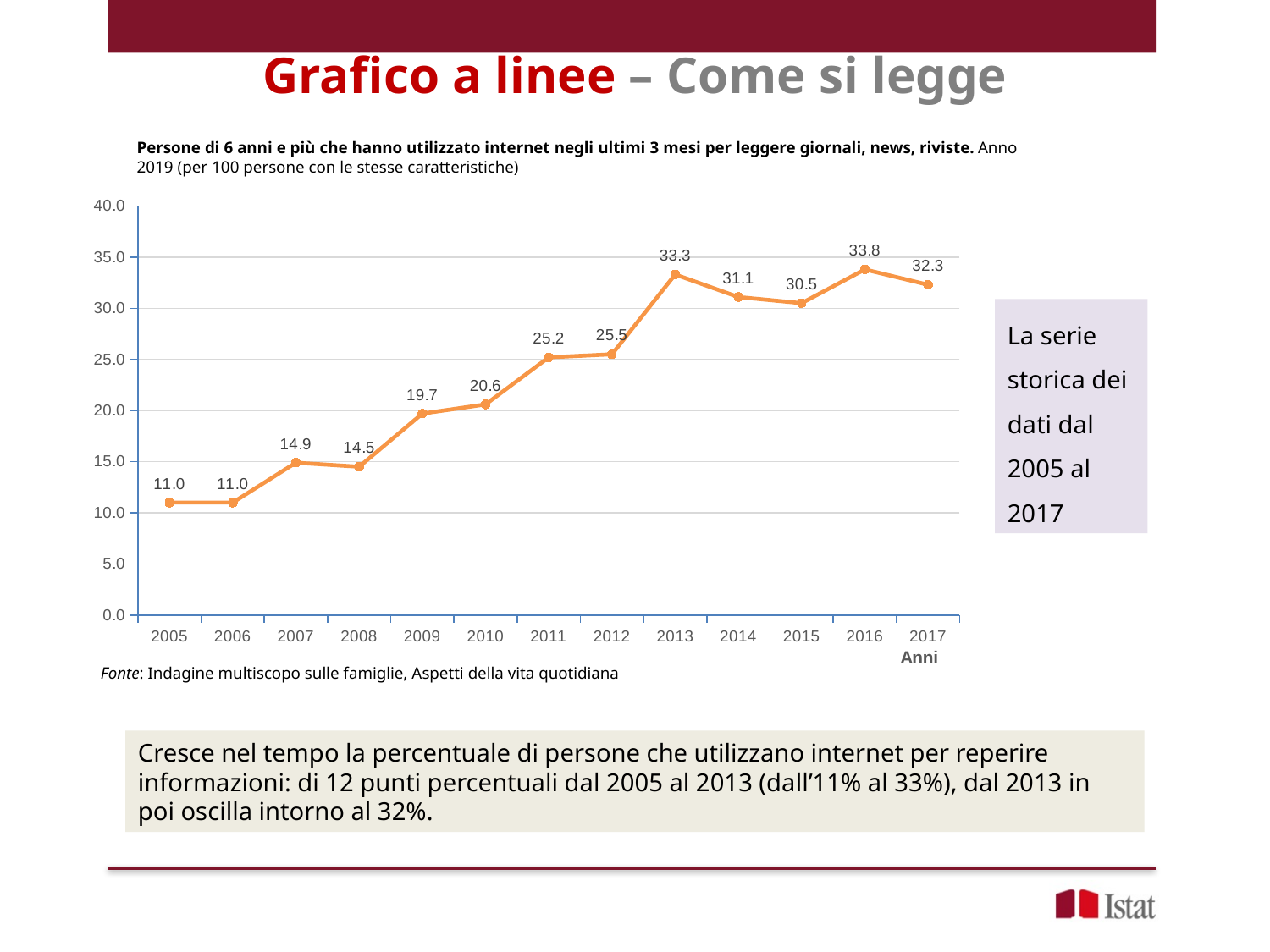
Which is larger, the value for 2014 or the value for 2015? 2014 Is the value for 2012 greater or less than 25.0? greater What is the difference between the values for 2013 and 2005? 22.3 What is the label of the x axis? Anni What is the value for 2017? 32.3 Which year has the highest value? 2016 Do the values generally rise or fall from 2005 to 2013? rise What is the value for 2013? 33.3 What is the lowest value shown on the chart? 11.0 What kind of chart is shown on the slide? line chart How many years are plotted on the x axis? 13 What is the value for 2009? 19.7